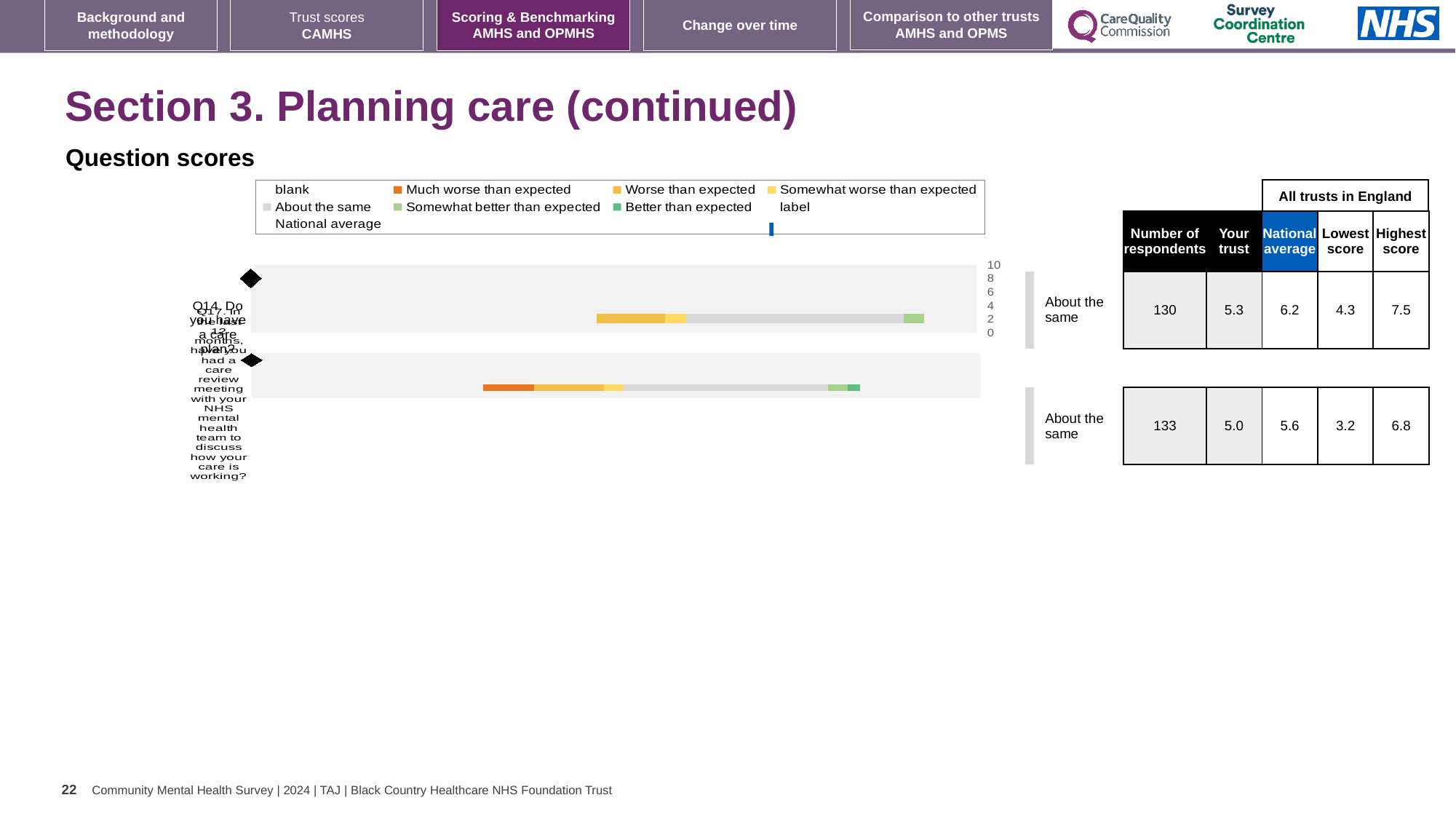
What is the national average score for Q17 (care review meeting in the last 12 months)? 5.6 What is the difference between the national average and the 'Your trust' score for Q14? 0.9 What is the highest score among all trusts in England for Q17? 6.8 What is the lowest score among all trusts in England for Q14? 4.3 What is the difference between the highest and lowest scores for Q17? 3.6 What is the 'Your trust' score for Q14 (Do you have a care plan?)? 5.3 What benchmark category is shown next to the Q14 bar? About the same How many questions are plotted in the question scores chart? 2 Which question has the higher 'Your trust' score, Q14 or Q17? Q14 What kind of chart is used to show the question scores on this slide? bar chart How many respondents answered Q14? 130 How many respondents answered Q17? 133